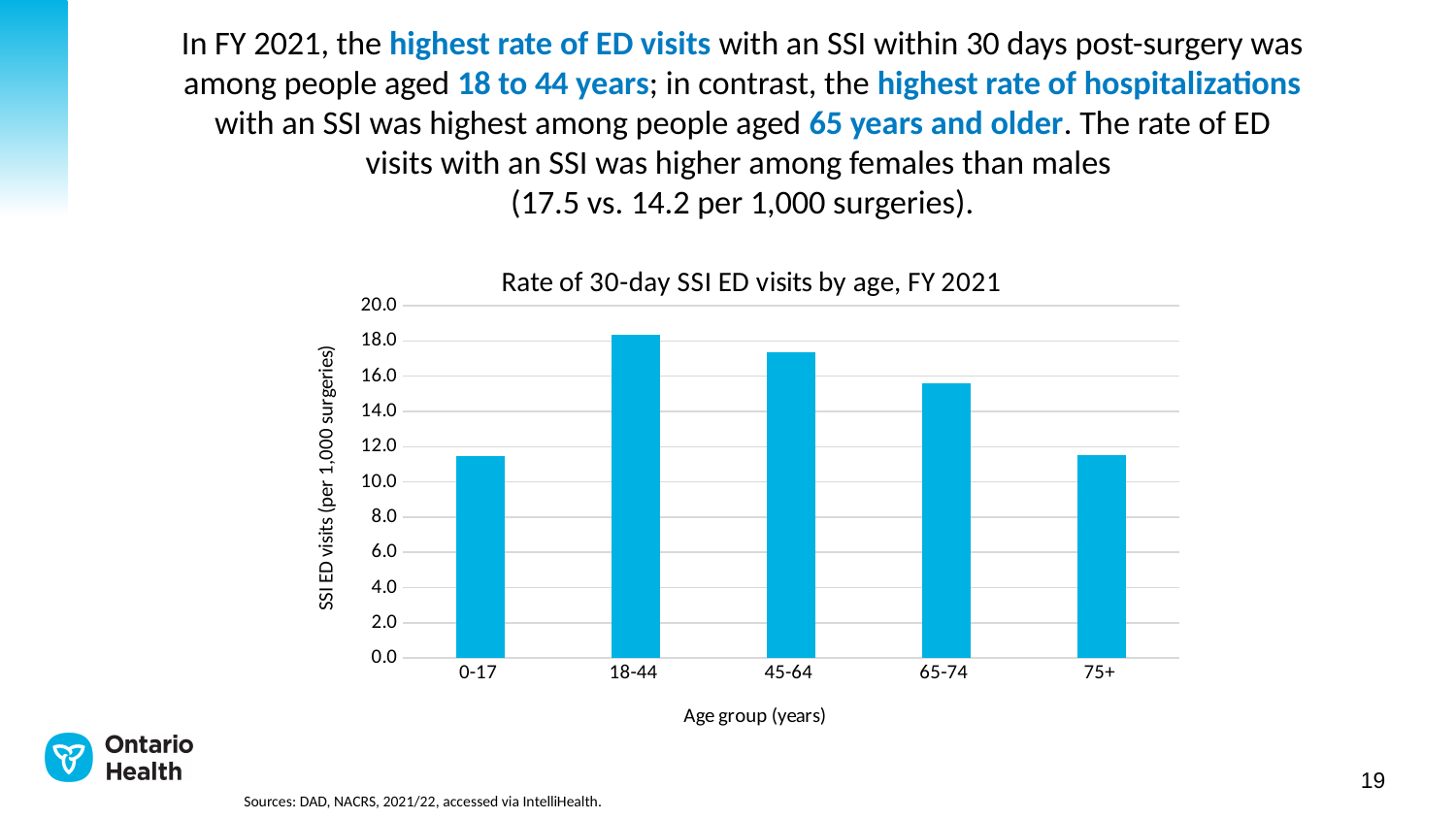
How many age groups are shown on the x axis of the chart? 5 What kind of chart is shown on the slide? Bar chart Which age group has the highest rate of 30-day SSI ED visits? 18-44 Is the value for the 0-17 age group greater or less than 12.0? less What is the title of the chart? Rate of 30-day SSI ED visits by age, FY 2021 Is the value for the 65-74 age group greater or less than 16.0? less Is the value for the 75+ age group greater or less than 10.0? greater Moving from the 18-44 age group to the 75+ age group, do the values rise or fall? fall Which has a higher rate of SSI ED visits, the 45-64 age group or the 65-74 age group? 45-64 Which has a higher rate of SSI ED visits, the 65-74 age group or the 75+ age group? 65-74